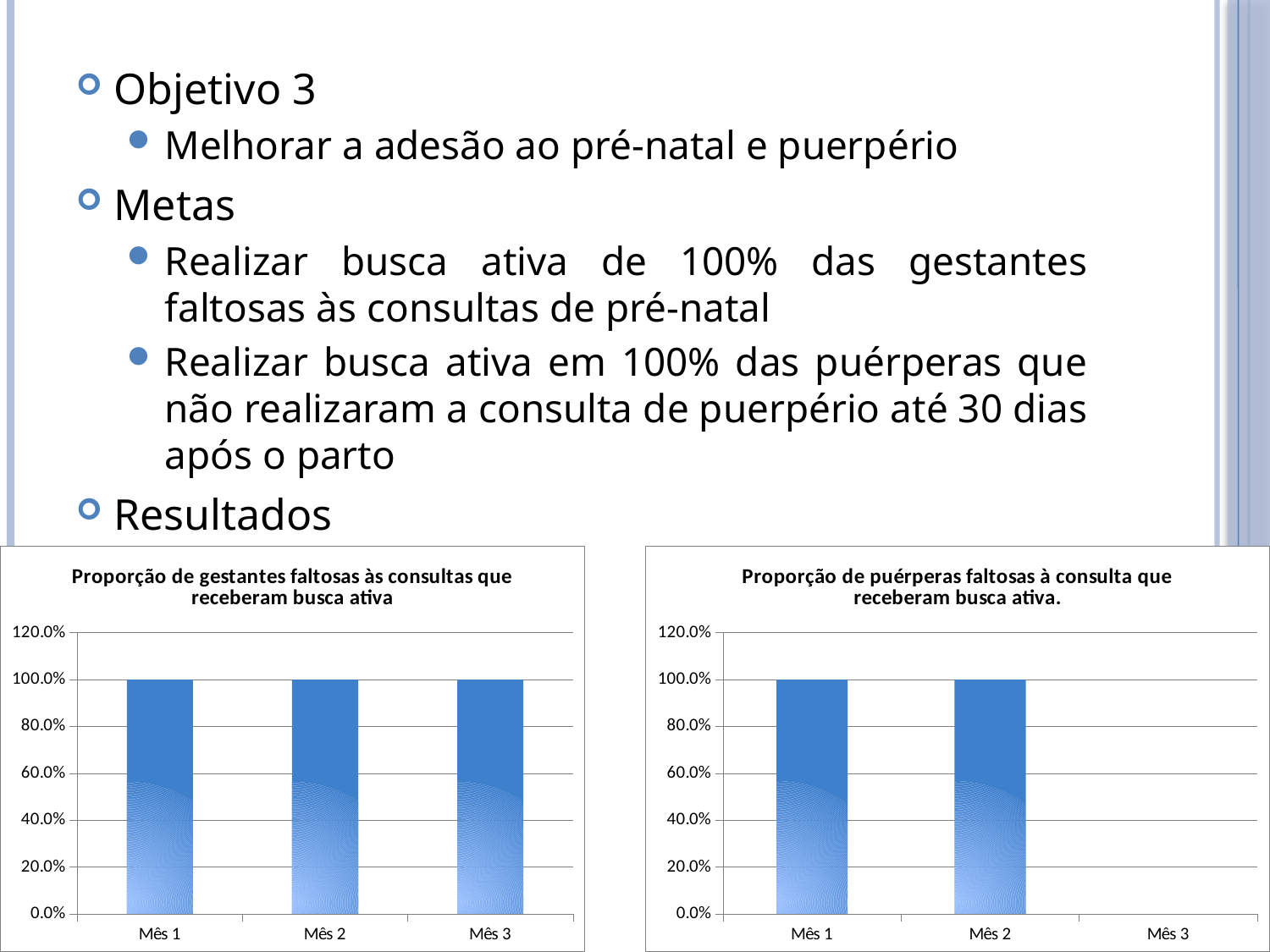
What is the title of the right chart? Proporção de puérperas faltosas à consulta que receberam busca ativa. How many bars are plotted in the right chart (Proporção de puérperas faltosas à consulta que receberam busca ativa)? 2 In the right chart (Proporção de puérperas faltosas à consulta que receberam busca ativa), what is the value for Mês 1? 100.0% What kind of chart is the left chart (Proporção de gestantes faltosas às consultas que receberam busca ativa)? bar chart What is the highest value shown on the y axis of the left chart (Proporção de gestantes faltosas às consultas que receberam busca ativa)? 120.0% How many categories are shown on the x axis of the left chart (Proporção de gestantes faltosas às consultas que receberam busca ativa)? 3 In the left chart (Proporção de gestantes faltosas às consultas que receberam busca ativa), what is the value for Mês 3? 100.0% In the left chart (Proporção de gestantes faltosas às consultas que receberam busca ativa), do the values rise, fall or stay the same from Mês 1 to Mês 3? stay the same In the left chart (Proporção de gestantes faltosas às consultas que receberam busca ativa), what is the difference between the values for Mês 1 and Mês 2? 0.0% In the right chart (Proporção de puérperas faltosas à consulta que receberam busca ativa), what is the value for Mês 2? 100.0% In the left chart (Proporção de gestantes faltosas às consultas que receberam busca ativa), what is the value for Mês 1? 100.0% In the right chart (Proporção de puérperas faltosas à consulta que receberam busca ativa), is the value for Mês 1 greater or less than 80.0%? greater